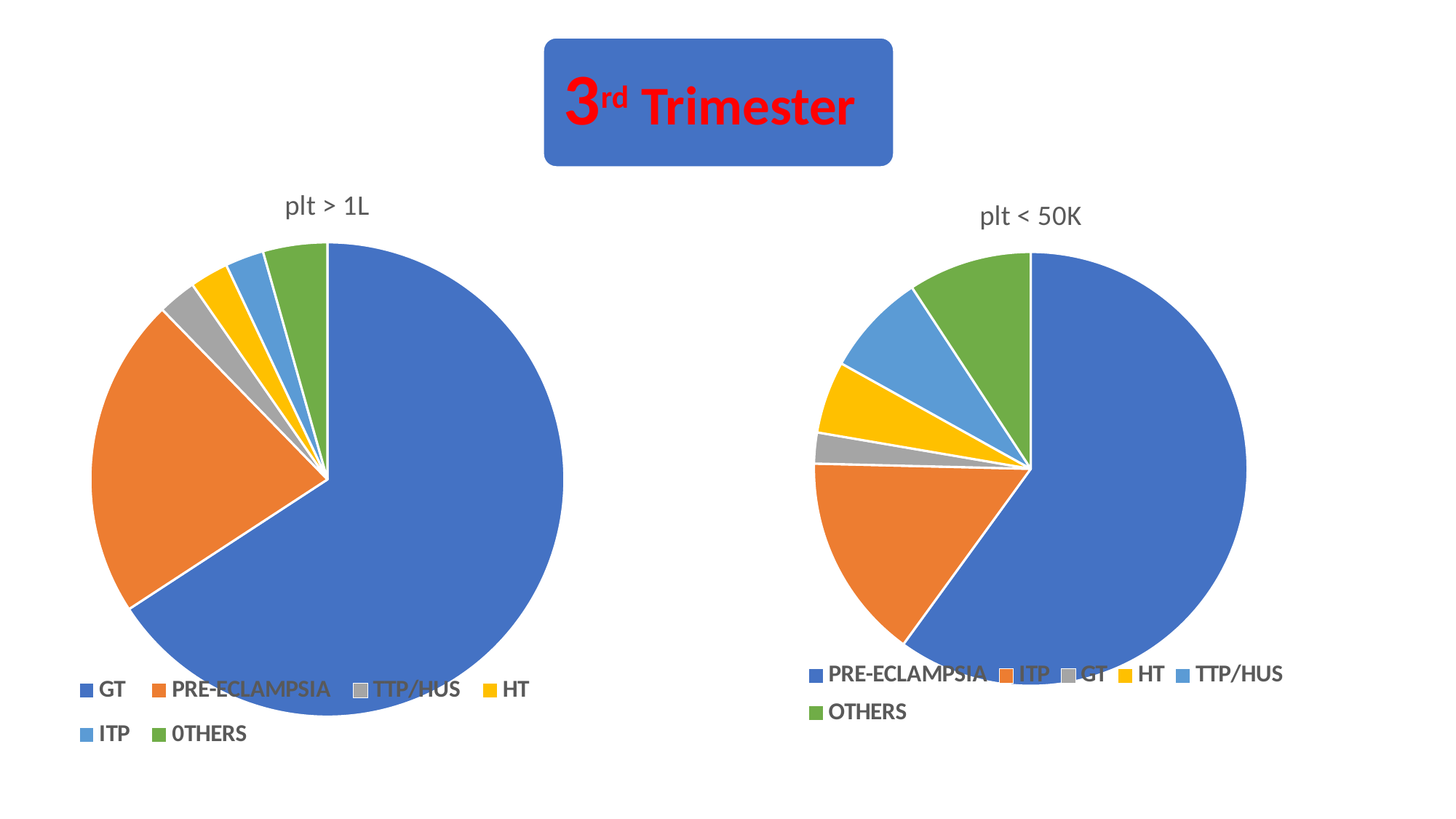
In the 'plt > 1L' chart, which category has the largest slice? GT In the 'plt < 50K' chart, which category has the smallest slice? GT How many categories are shown in the 'plt < 50K' chart? 6 What kind of chart is the 'plt > 1L' chart? pie chart In the 'plt > 1L' chart, which slice is larger, GT or PRE-ECLAMPSIA? GT In the 'plt < 50K' chart, which category has the largest slice? PRE-ECLAMPSIA What is the title of the chart on the right side of the slide? plt < 50K What kind of chart is the 'plt < 50K' chart? pie chart In the 'plt > 1L' chart, which slice is larger, PRE-ECLAMPSIA or 0THERS? PRE-ECLAMPSIA In the 'plt < 50K' chart, which slice is larger, ITP or OTHERS? ITP How many categories are shown in the 'plt > 1L' chart? 6 In the 'plt < 50K' chart, which category is shown in orange? ITP